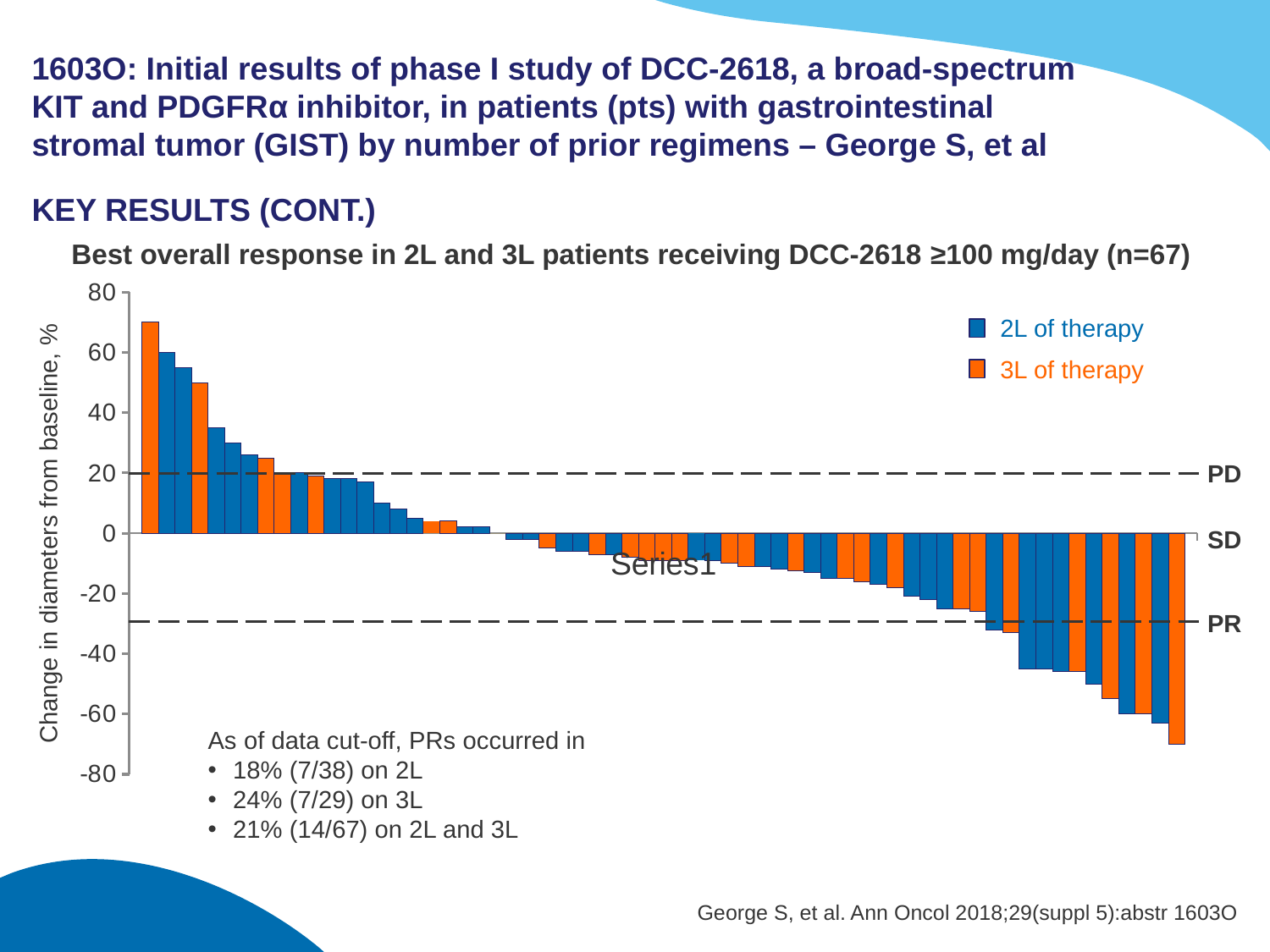
What is the label of the vertical axis? Change in diameters from baseline, % What kind of chart is shown on the slide? Bar chart Which series does the lowest bar (the rightmost bar) belong to? 3L of therapy Do the bar values rise or fall moving from left to right along the x axis? fall What are the two series named in the legend? 2L of therapy and 3L of therapy How many patients are included in the chart, according to its title? 67 How many series does the legend list? 2 Is the value of the leftmost bar greater or less than 60? greater Is the leftmost bar taller or shorter than the second bar from the left? taller What is the highest value shown on the vertical axis? 80 Which series does the tallest bar (the leftmost bar) belong to? 3L of therapy Is the value of the rightmost bar greater or less than -60? less